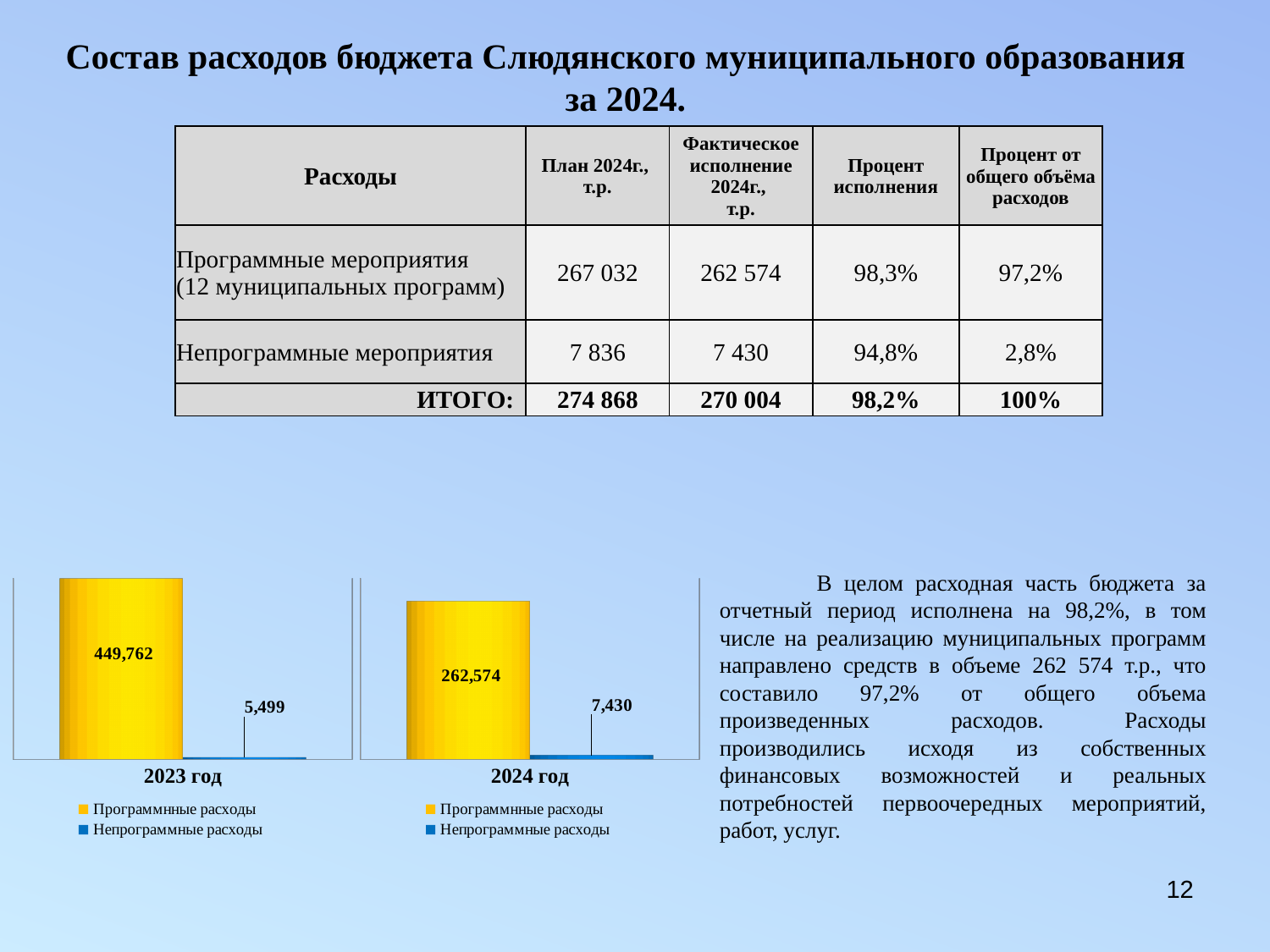
In the 2023 год chart, what is the value for Непрограммные расходы? 5,499 How many series does the legend of the 2024 год chart list? 2 In the 2023 год chart, what is the value for Программные расходы? 449,762 In the 2024 год chart, what is the difference between Программные расходы and Непрограммные расходы? 255,144 What kind of chart is the 2023 год chart? Bar chart In the 2023 год chart, which series has the lowest value? Непрограммные расходы In the 2023 год chart, what is the difference between Программные расходы and Непрограммные расходы? 444,263 In the 2024 год chart, what is the value for Программные расходы? 262,574 In the 2024 год chart, which series has the highest value? Программные расходы In the 2024 год chart, what colour is the bar for Программные расходы? Yellow Comparing the 2023 год and 2024 год charts, which year has the larger value for Непрограммные расходы? 2024 год In the 2024 год chart, what is the value for Непрограммные расходы? 7,430